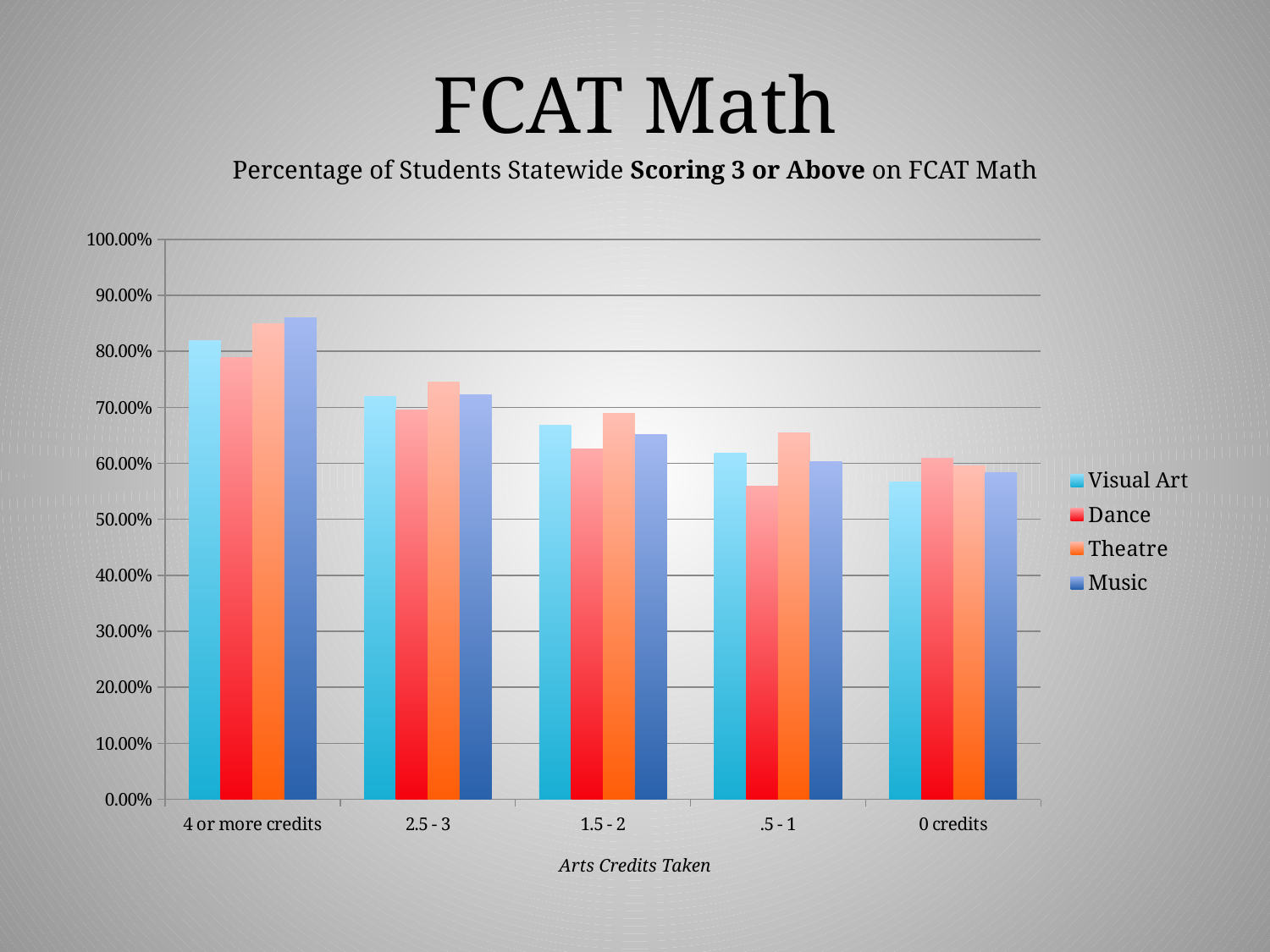
Do the Music values rise or fall moving from '4 or more credits' to '0 credits' along the x axis? fall How many arts-credit categories are shown on the x axis? 5 Which is larger: the Visual Art value for '4 or more credits' or for '0 credits'? 4 or more credits Is the Visual Art value for '4 or more credits' greater or less than 80.00%? greater In which category is the Music bar highest? 4 or more credits Is the Theatre value for '.5 - 1' credits greater or less than 60.00%? greater What kind of chart is shown on the slide? Bar chart How many series does the legend list? 4 What is the title of the x axis? Arts Credits Taken Is the Dance value for '.5 - 1' credits greater or less than 60.00%? less Which series has the lowest value in the '.5 - 1' credits category? Dance